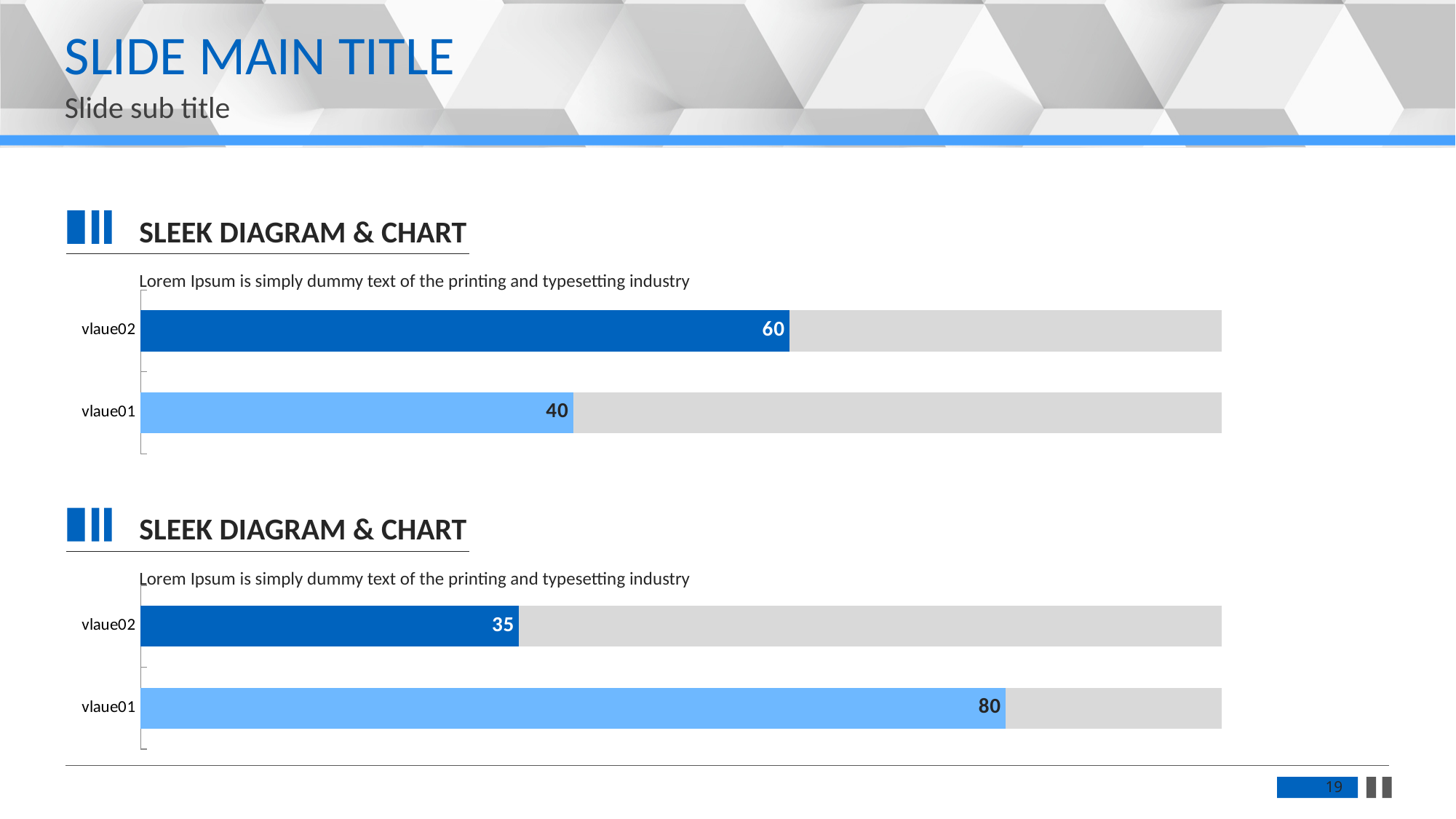
In the top chart, what is the value for vlaue02? 60 How many categories does the top chart show? 2 In the bottom chart, what is the value for vlaue02? 35 What kind of chart is the bottom chart? bar chart In the bottom chart, what is the value for vlaue01? 80 What is the heading shown above the top chart? SLEEK DIAGRAM & CHART In the bottom chart, which category has the lowest value? vlaue02 In the bottom chart, what is the difference between the values for vlaue01 and vlaue02? 45 In the top chart, what is the value for vlaue01? 40 In the bottom chart, which is larger, the value for vlaue01 or vlaue02? vlaue01 In the top chart, what is the difference between the values for vlaue02 and vlaue01? 20 In the top chart, which category has the highest value? vlaue02